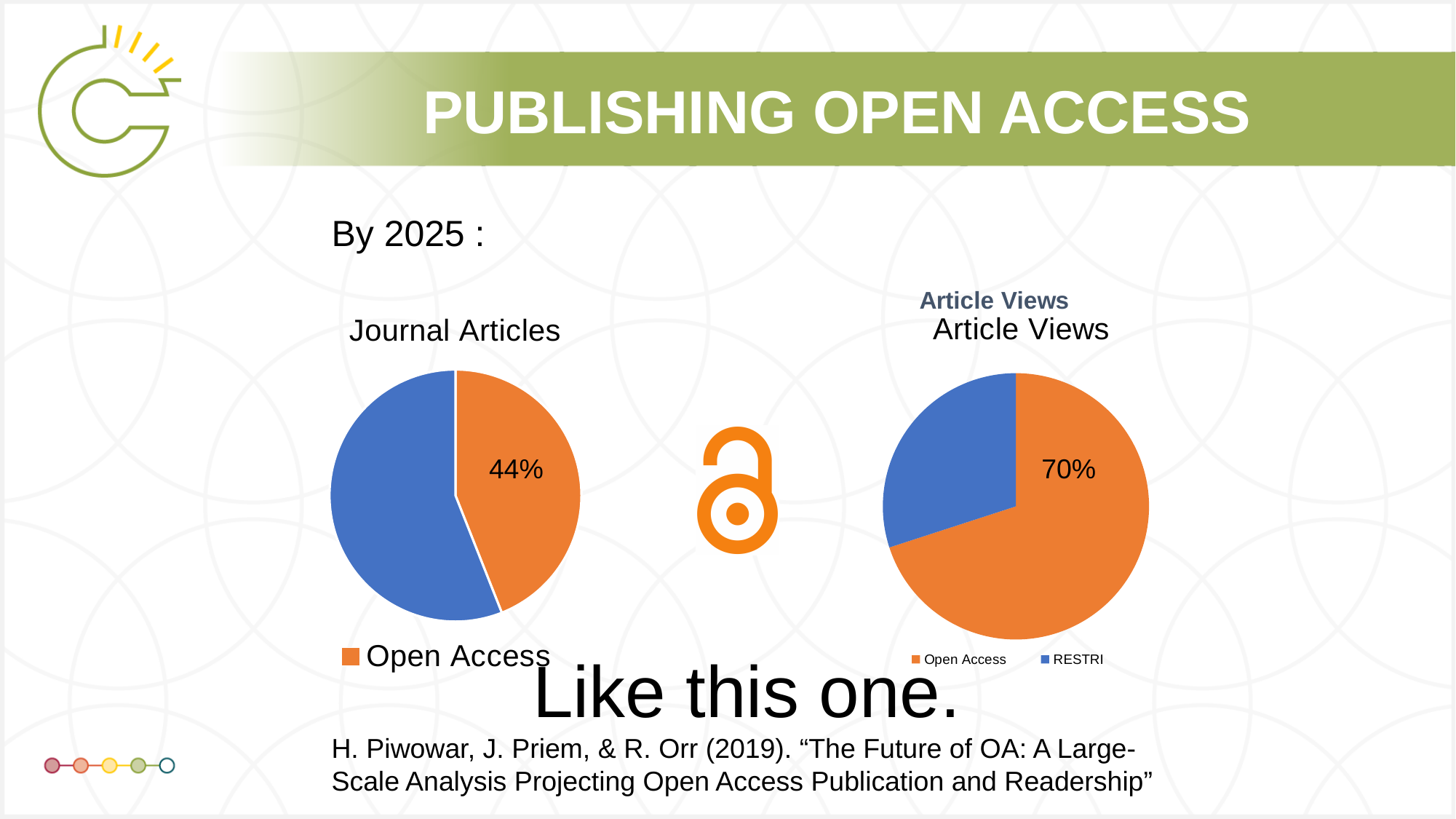
In the Journal Articles chart, is the Open Access slice more or less than half of the pie? Less What colour is the Open Access slice in the Journal Articles chart? Orange What is the difference between the Open Access share in the Article Views chart and the Open Access share in the Journal Articles chart? 26 percentage points Which chart shows a larger Open Access share, Journal Articles or Article Views? Article Views In the Article Views chart, what share is labelled for Open Access? 70% What kind of chart is the Journal Articles chart? Pie chart What is the title of the pie chart on the left of the slide? Journal Articles How many entries does the legend of the Article Views chart list? 2 In the Journal Articles chart, what share is labelled for Open Access? 44% How many slices does the Article Views pie chart have? 2 In the Article Views chart, which slice is the largest? Open Access What kind of chart is the Article Views chart? Pie chart